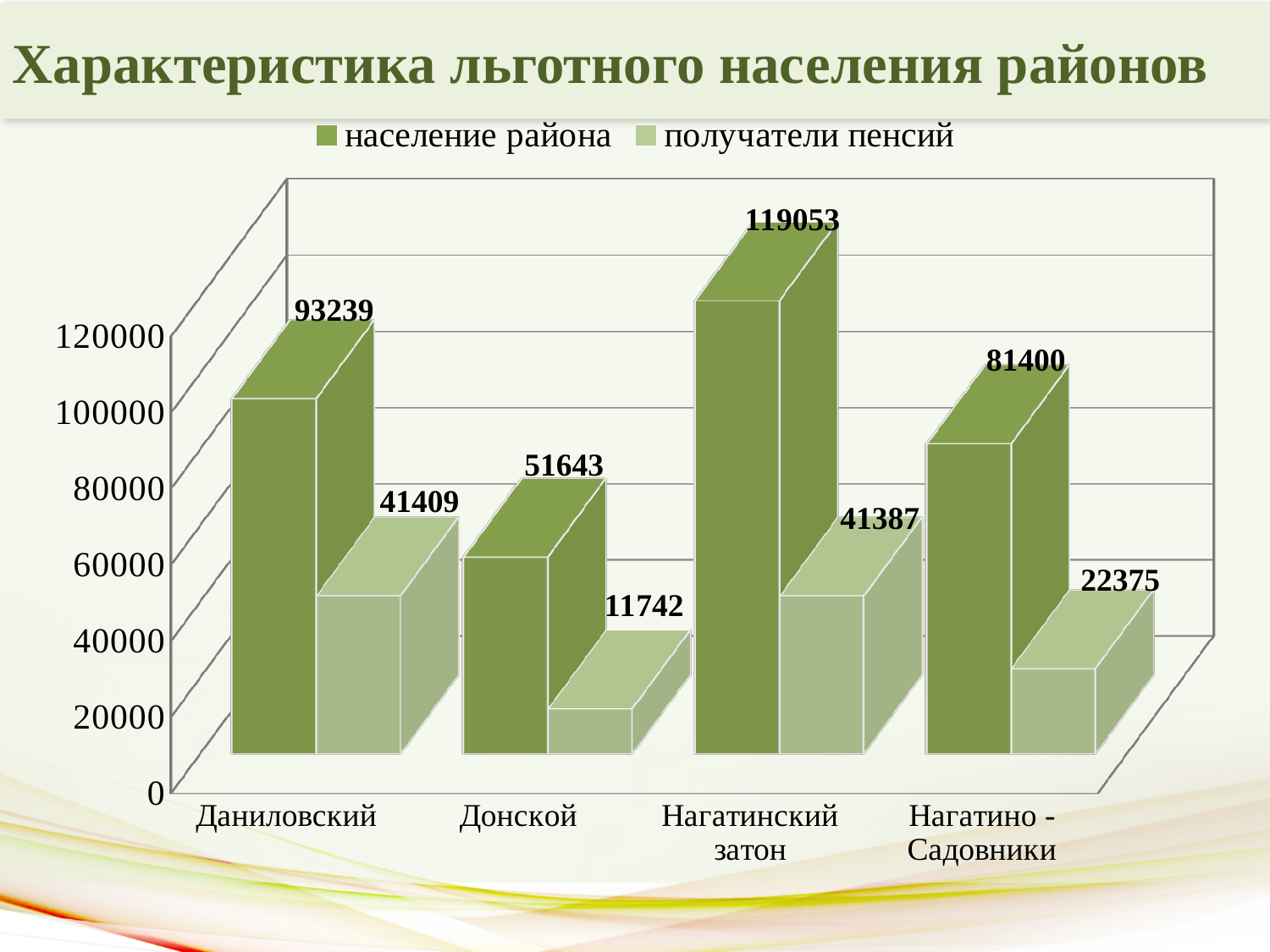
Which district has the lowest value for получатели пенсий? Донской What kind of chart is shown on the slide? bar chart Is the value of население района for Нагатино - Садовники greater or less than 100000? less How many districts are shown on the x axis? 4 What is the value of получатели пенсий for Нагатино - Садовники? 22375 Which district has the highest value for население района? Нагатинский затон What is the value of население района for Нагатинский затон? 119053 How many series does the legend list? 2 What is the value of получатели пенсий for Донской? 11742 What is the title of the slide? Характеристика льготного населения районов Which is larger: получатели пенсий for Даниловский or for Нагатинский затон? Даниловский What is the difference between население района and получатели пенсий for Даниловский? 51830